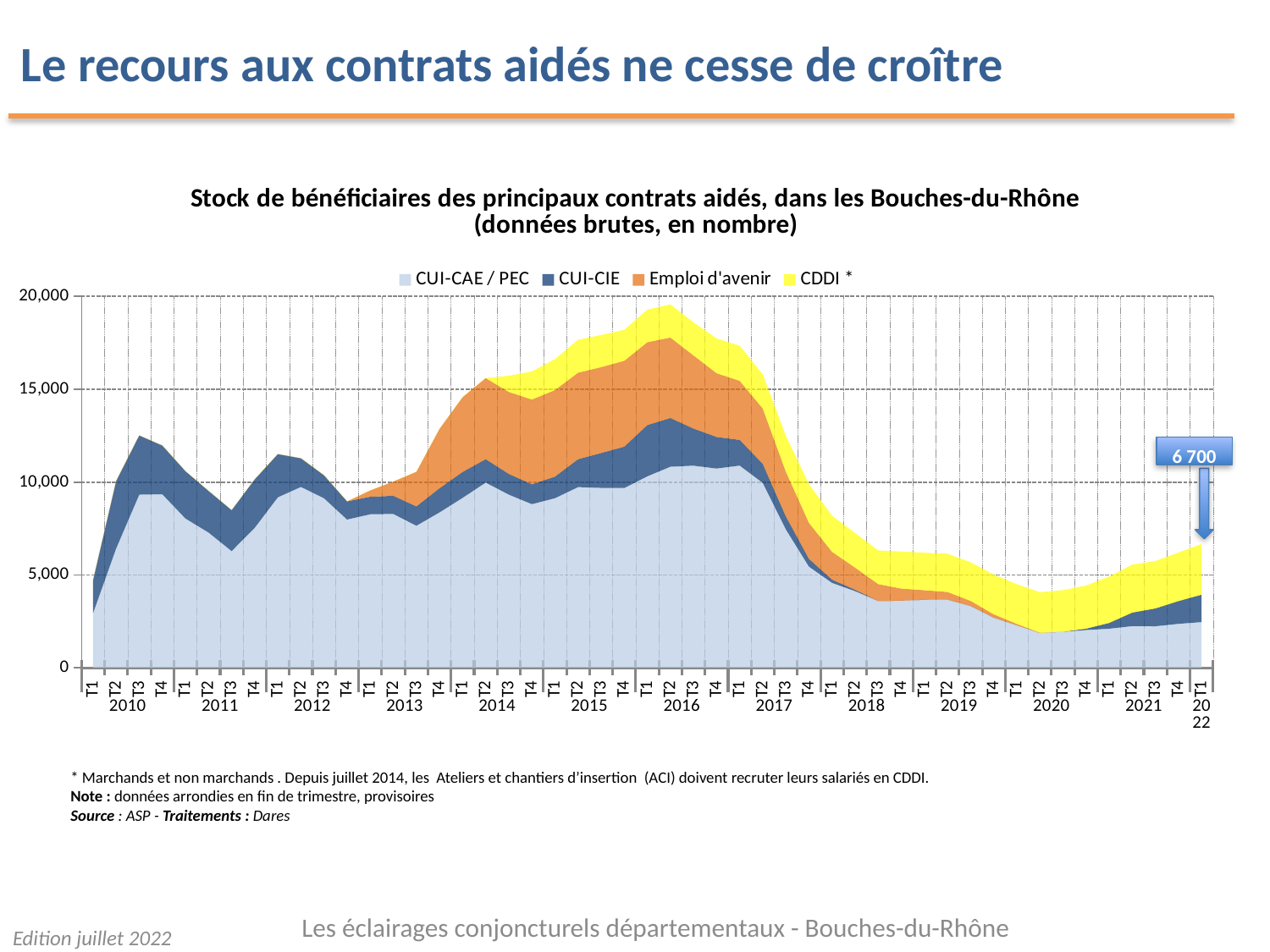
Is the total stock of beneficiaries at T2 2016 greater or less than 15,000? greater Which series is shown in yellow? CDDI * In which year does the total stock of beneficiaries reach its highest level? 2016 Does the total stock of beneficiaries rise or fall between 2017 and 2020? Fall Which series is at the bottom of the stack? CUI-CAE / PEC What kind of chart is shown on the slide? Stacked area chart How many series does the legend list? 4 Does the total stock of beneficiaries rise or fall between T3 2020 and T1 2022? Rise What total value is annotated for T1 2022? 6 700 Is the total stock of beneficiaries at T3 2020 greater or less than 5,000? less Is the value for CUI-CAE / PEC at T3 2010 greater or less than 5,000? greater